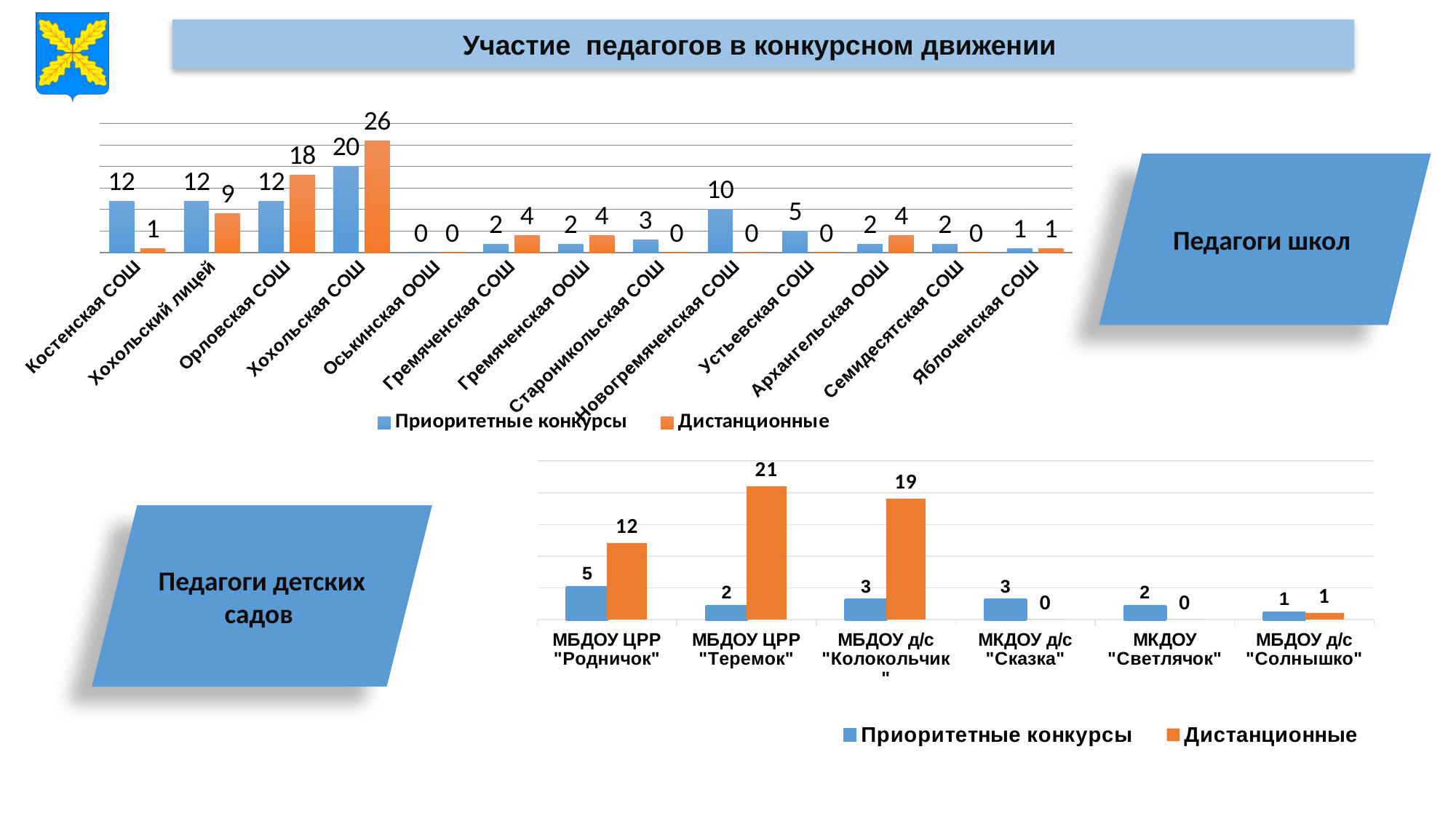
In the bottom chart (Педагоги детских садов), what is the difference between Дистанционные and Приоритетные конкурсы for МБДОУ д/с "Колокольчик"? 16 In the top chart (Педагоги школ), which school has the highest value for Приоритетные конкурсы? Хохольская СОШ What type of chart is the top chart (Педагоги школ)? Bar chart In the top chart (Педагоги школ), which is larger for Хохольский лицей: Приоритетные конкурсы or Дистанционные? Приоритетные конкурсы In the bottom chart (Педагоги детских садов), which kindergarten has the highest value for Приоритетные конкурсы? МБДОУ ЦРР "Родничок" In the top chart (Педагоги школ), how many schools are shown on the x axis? 13 How many series does the legend of the bottom chart (Педагоги детских садов) list? 2 In the bottom chart (Педагоги детских садов), how many kindergartens are shown on the x axis? 6 In the bottom chart (Педагоги детских садов), what is the value of Дистанционные for МБДОУ ЦРР "Теремок"? 21 In the top chart (Педагоги школ), what is the value of Приоритетные конкурсы for Новогремяченская СОШ? 10 In the top chart (Педагоги школ), what is the value of Дистанционные for Хохольская СОШ? 26 In the top chart (Педагоги школ), what is the difference between Дистанционные and Приоритетные конкурсы for Орловская СОШ? 6